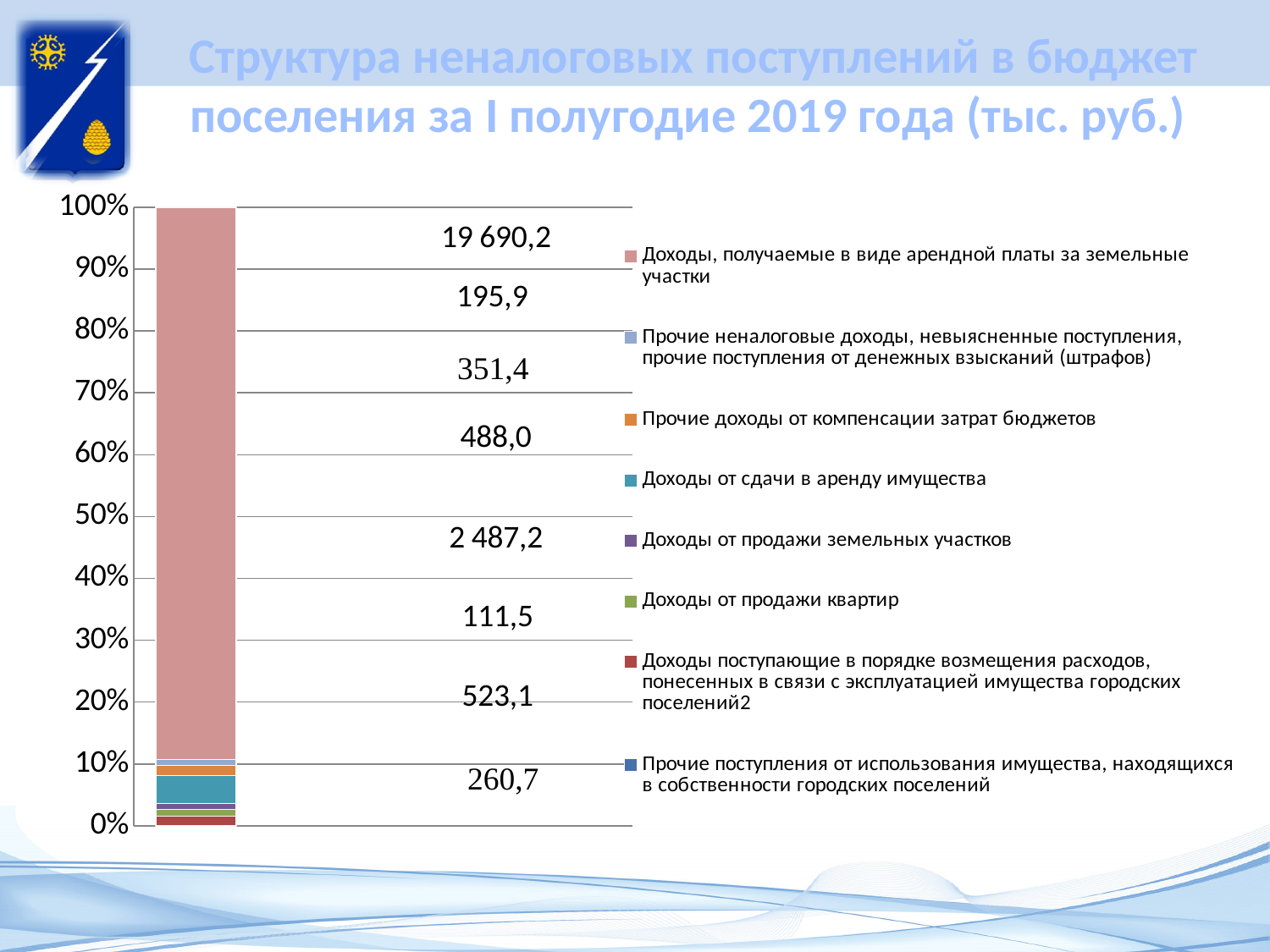
Does the segment for 'Доходы, получаемые в виде арендной платы за земельные участки' occupy greater or less than 80% of the bar? greater How many series does the legend list? 8 What is the title of the chart on the slide? Структура неналоговых поступлений в бюджет поселения за I полугодие 2019 года (тыс. руб.) What is the bottommost data label value shown on the chart? 260,7 Which legend entry is listed first? Доходы, получаемые в виде арендной платы за земельные участки What kind of chart is shown on the slide? Stacked bar chart What is the topmost data label value shown on the chart? 19 690,2 What is the smallest value printed on the chart? 111,5 How many data labels are printed on the chart? 8 Does the segment for 'Доходы от сдачи в аренду имущества' occupy greater or less than 10% of the bar? less What is the largest value printed on the chart? 19 690,2